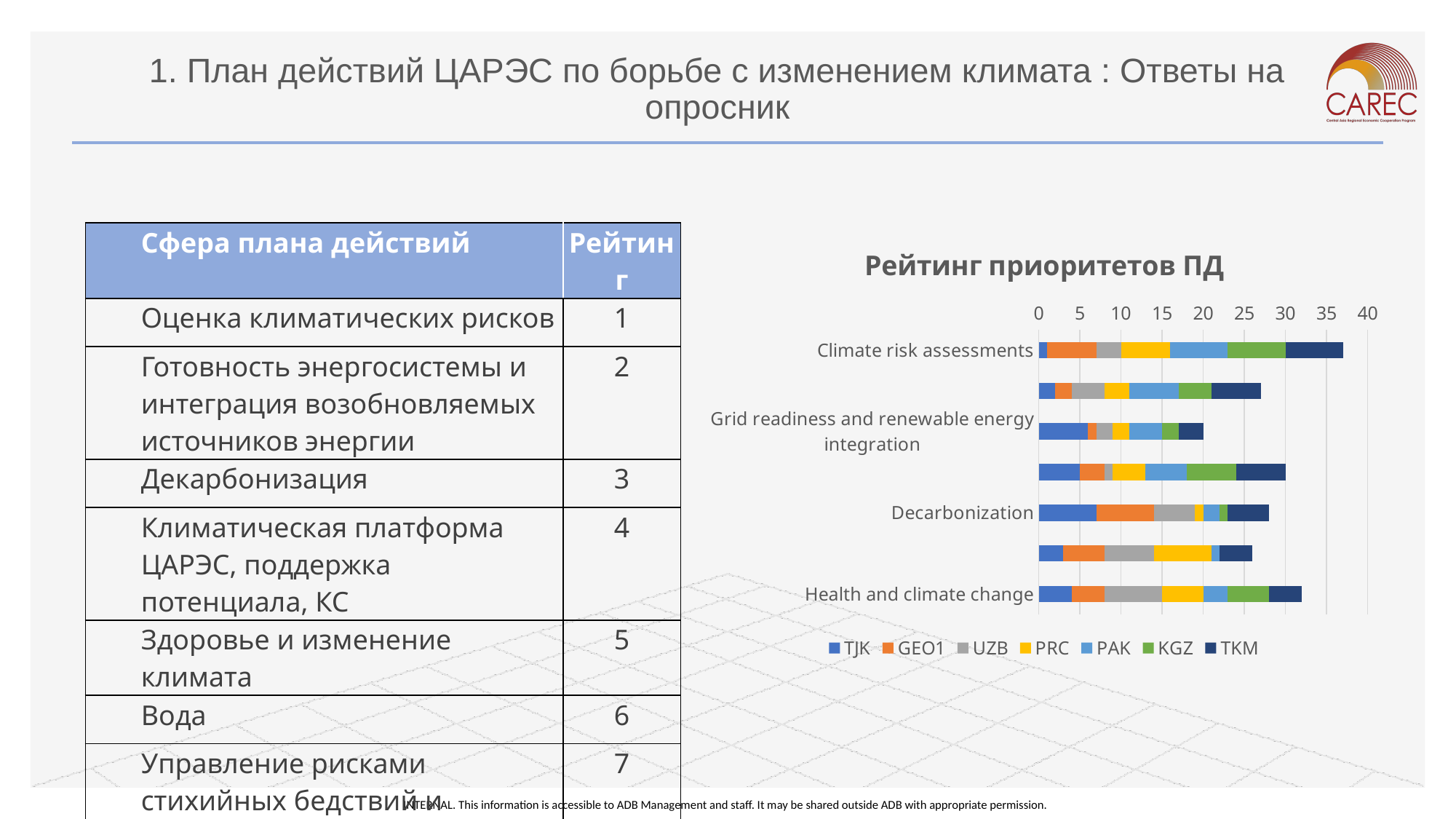
How many series does the chart legend list? 7 Is the total bar length for Decarbonization greater or less than 30? less Is the total bar length for Climate risk assessments greater or less than 35? greater Which bar is longer: Climate risk assessments or Decarbonization? Climate risk assessments Which series is listed last in the chart legend? TKM Which labelled category has the shortest bar in the chart? Grid readiness and renewable energy integration How many bars are plotted in the chart? 7 Is the total bar length for Health and climate change greater or less than 30? greater What is the title of the chart on the slide? Рейтинг приоритетов ПД What kind of chart is shown on the slide? bar chart Which category has the longest bar in the chart? Climate risk assessments